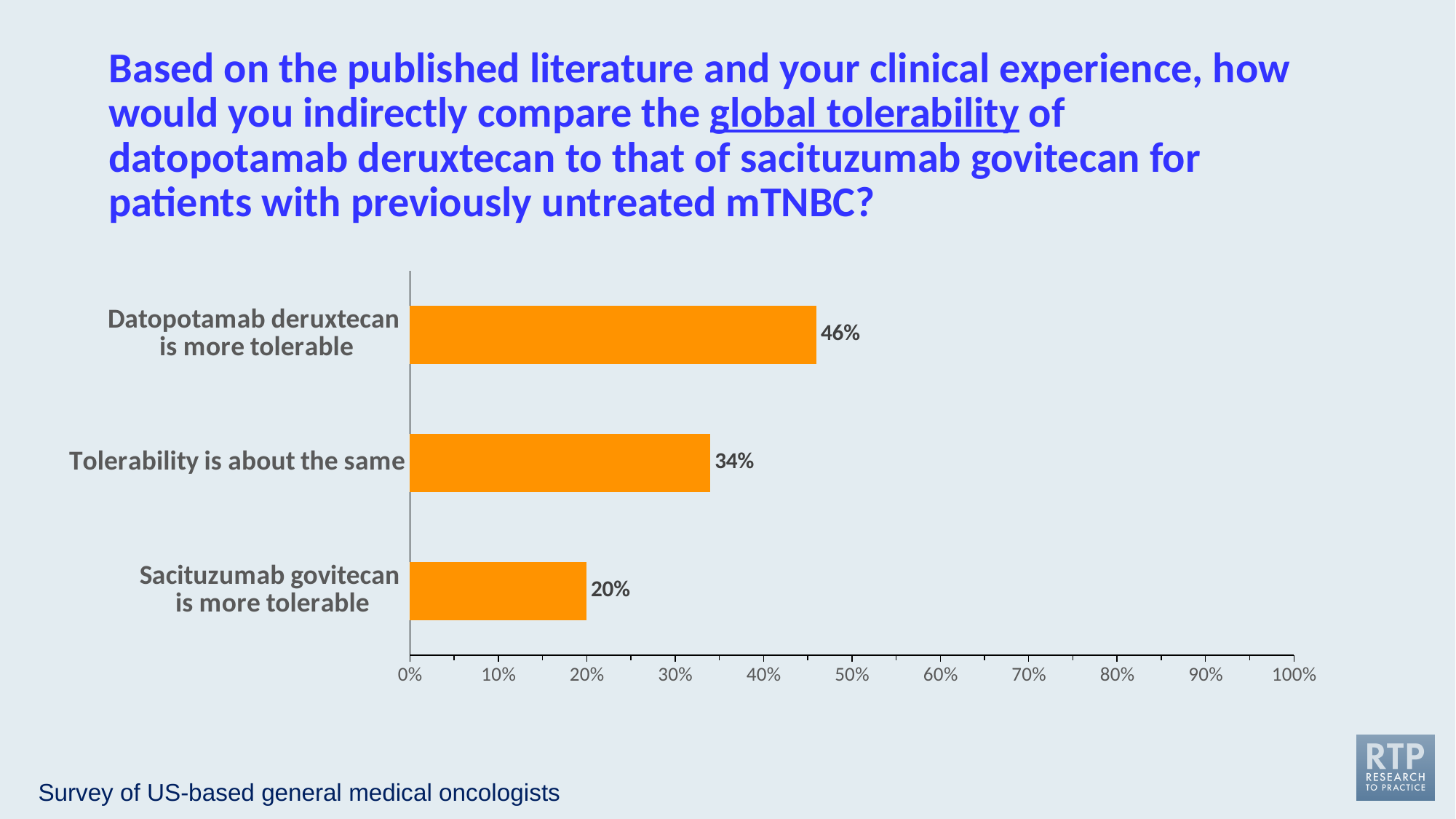
What is the difference in percentage points between 'Datopotamab deruxtecan is more tolerable' and 'Tolerability is about the same'? 12 percentage points What percentage of respondents said datopotamab deruxtecan is more tolerable? 46% Is the value for 'Datopotamab deruxtecan is more tolerable' greater or less than 50%? less What percentage of respondents said tolerability is about the same? 34% What percentage of respondents said sacituzumab govitecan is more tolerable? 20% Which received a larger share of responses: 'Tolerability is about the same' or 'Sacituzumab govitecan is more tolerable'? Tolerability is about the same What is the maximum value shown on the x axis? 100% How many response options are shown in the chart? 3 What is the difference in percentage points between 'Datopotamab deruxtecan is more tolerable' and 'Sacituzumab govitecan is more tolerable'? 26 percentage points Which response option received the highest percentage? Datopotamab deruxtecan is more tolerable Which response option received the lowest percentage? Sacituzumab govitecan is more tolerable What type of chart is shown on the slide? Bar chart